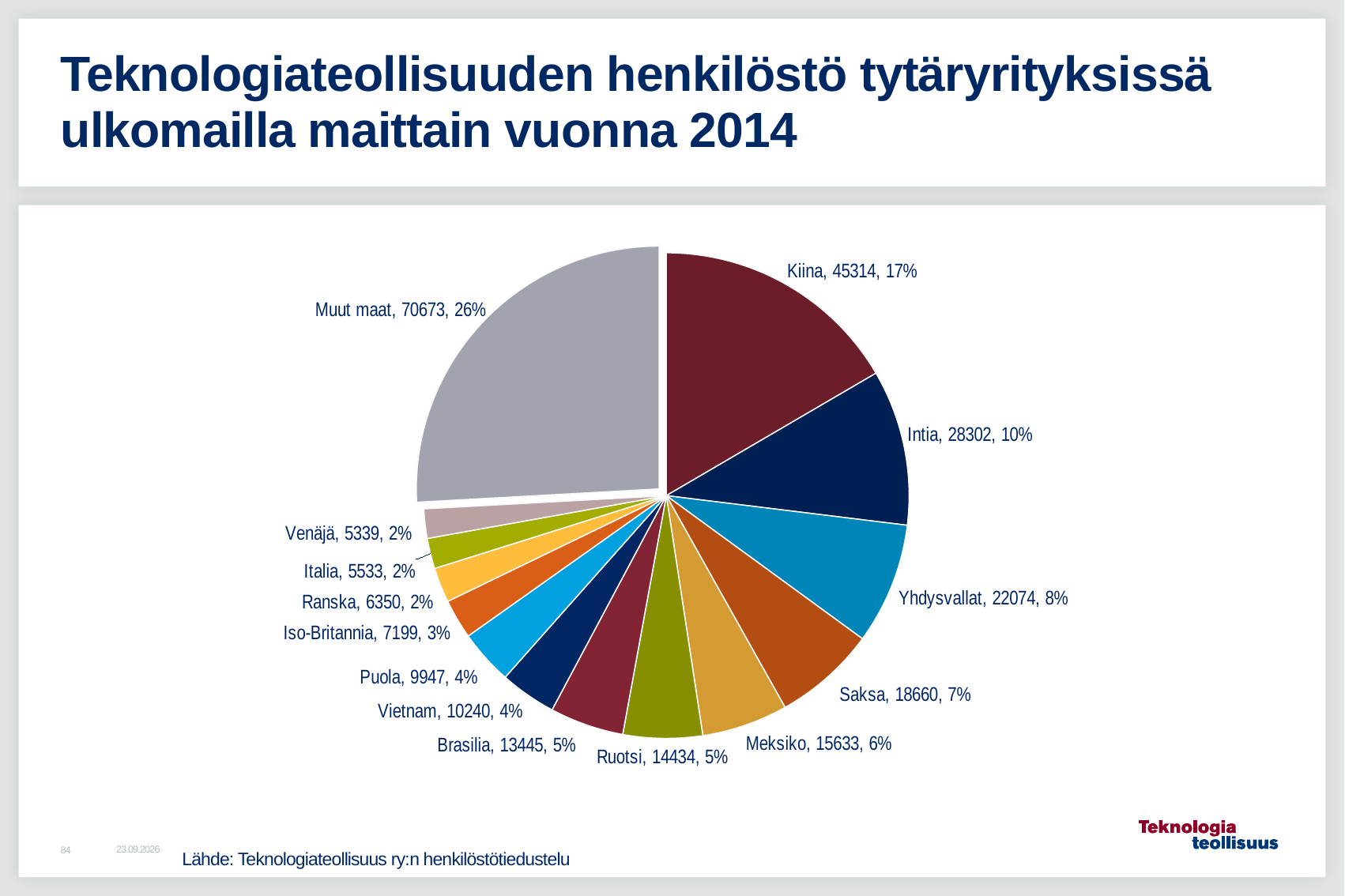
What is the value for Saksa? 18660 What is the value for Kiina? 45314 What kind of chart is shown on the slide? pie chart What is the difference between the values for Kiina and Intia? 17012 What share of the pie does Muut maat represent? 26% Which is larger, the value for Yhdysvallat or the value for Saksa? Yhdysvallat What share of the pie does Intia represent? 10% How many slices does the pie chart have? 14 Which slice is the smallest? Venäjä Which slice is the largest? Muut maat What is the value for Vietnam? 10240 What is the title of the chart on the slide? Teknologiateollisuuden henkilöstö tytäryrityksissä ulkomailla maittain vuonna 2014